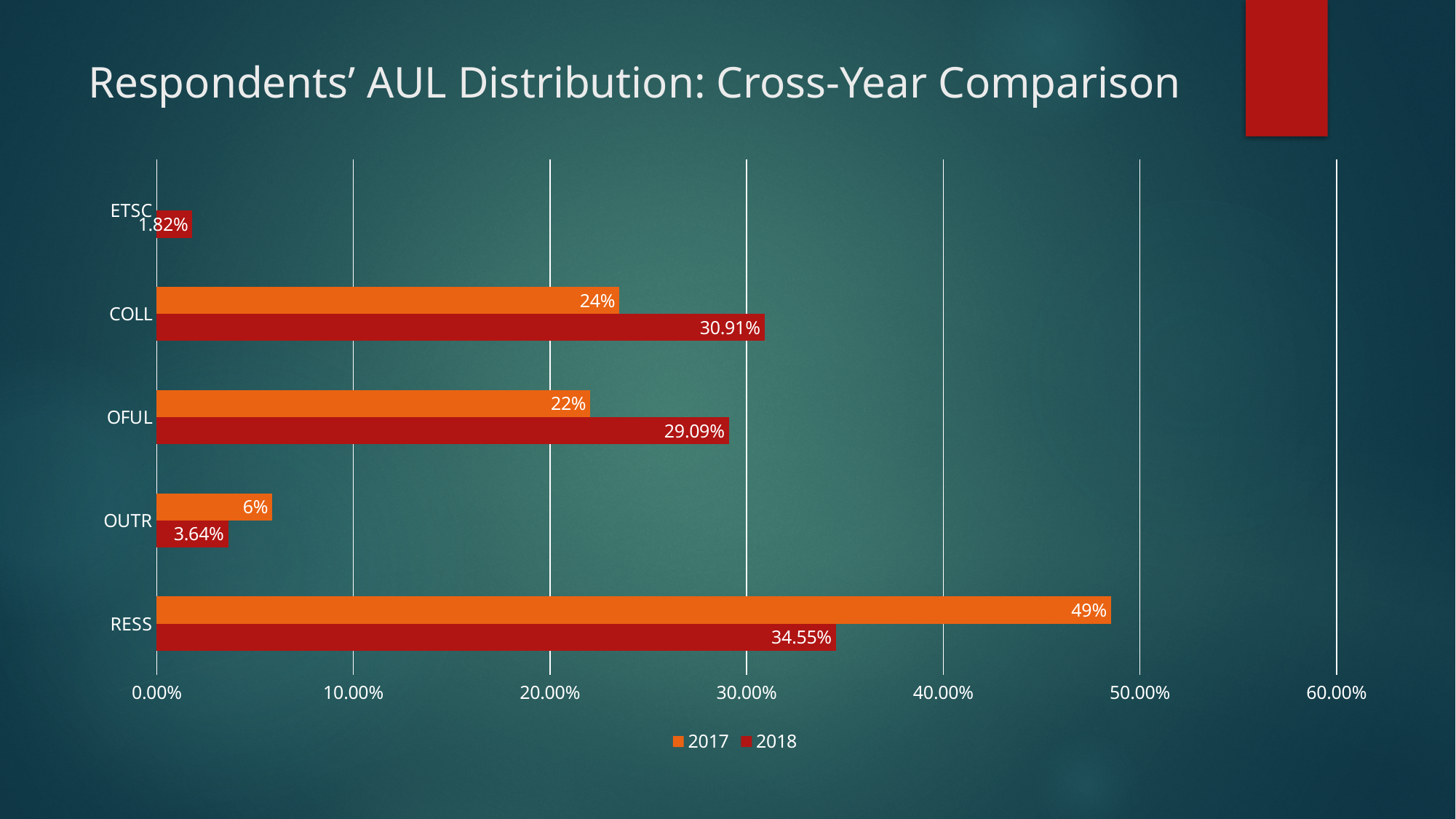
What is the 2018 value for ETSC? 1.82% What type of chart is shown on the slide? bar chart What is the difference between the 2017 and 2018 values for RESS? 14.45% How many series does the legend list? 2 Which category has the highest 2018 value? RESS What is the title of the chart? Respondents' AUL Distribution: Cross-Year Comparison How many categories are shown on the y axis? 5 What is the 2017 value for RESS? 49% What is the 2018 value for COLL? 30.91% Which category has the lowest 2018 value? ETSC Which is larger for OFUL, the 2017 value or the 2018 value? 2018 What is the 2017 value for OUTR? 6%